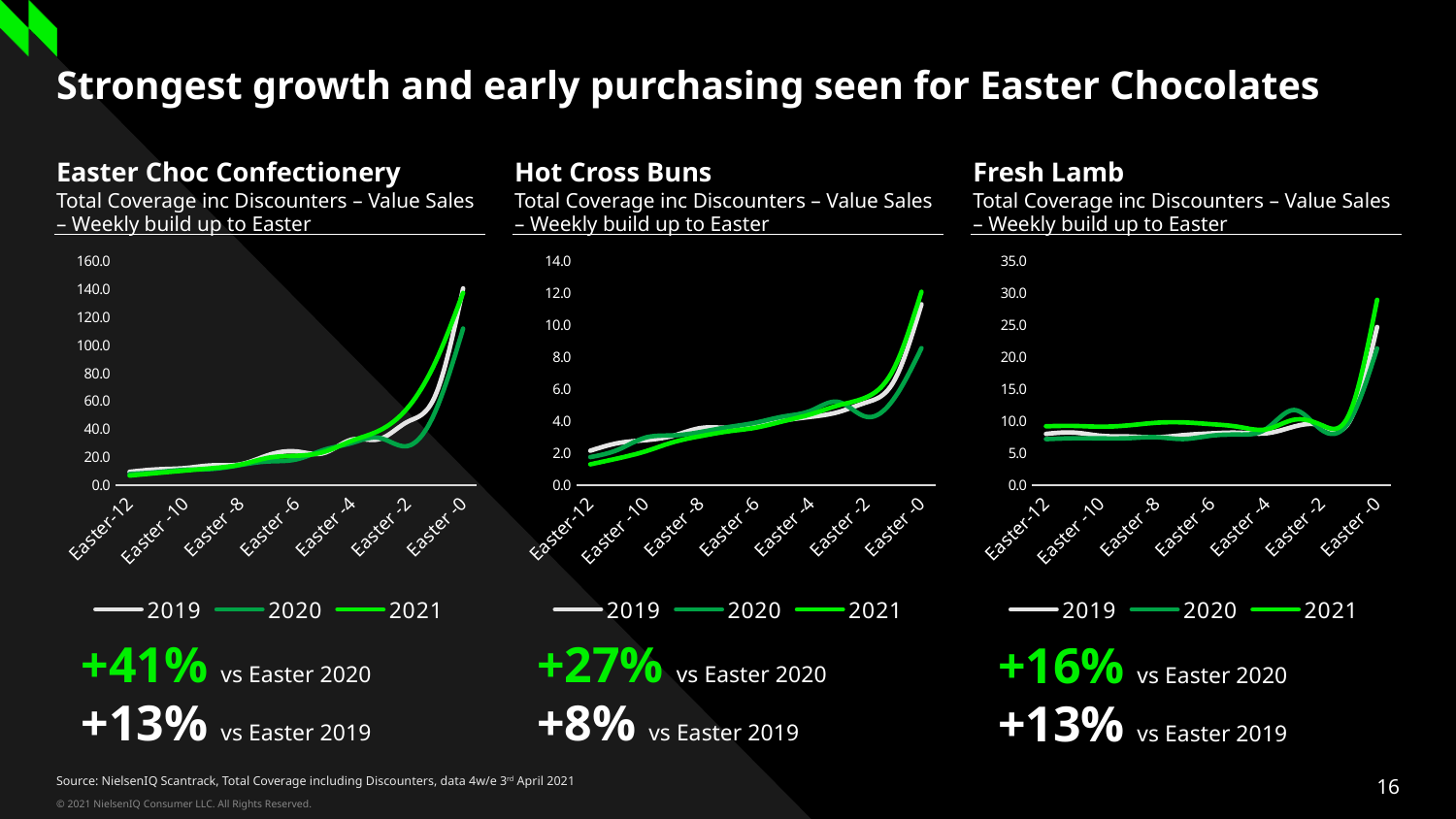
On the Hot Cross Buns chart, is the 2020 value at Easter -0 greater or less than 10? less How many series does the legend list on the Hot Cross Buns chart? 3 On the Easter Choc Confectionery chart, is the 2021 value at Easter -0 greater or less than 120? greater On the Fresh Lamb chart, is the 2021 value at Easter -0 greater or less than 25? greater On the Easter Choc Confectionery chart, do the values rise or fall from Easter -12 to Easter -0? Rise How many weekly points are labelled on the x axis of the Fresh Lamb chart? 7 Which years are listed in the legend of the Fresh Lamb chart? 2019, 2020, 2021 On the Hot Cross Buns chart, which year has the lowest value at Easter -0? 2020 What kind of chart is used for Easter Choc Confectionery? Line chart What is the highest value shown on the y axis of the Hot Cross Buns chart? 14.0 On the Fresh Lamb chart, which year has the lowest value at Easter -0? 2020